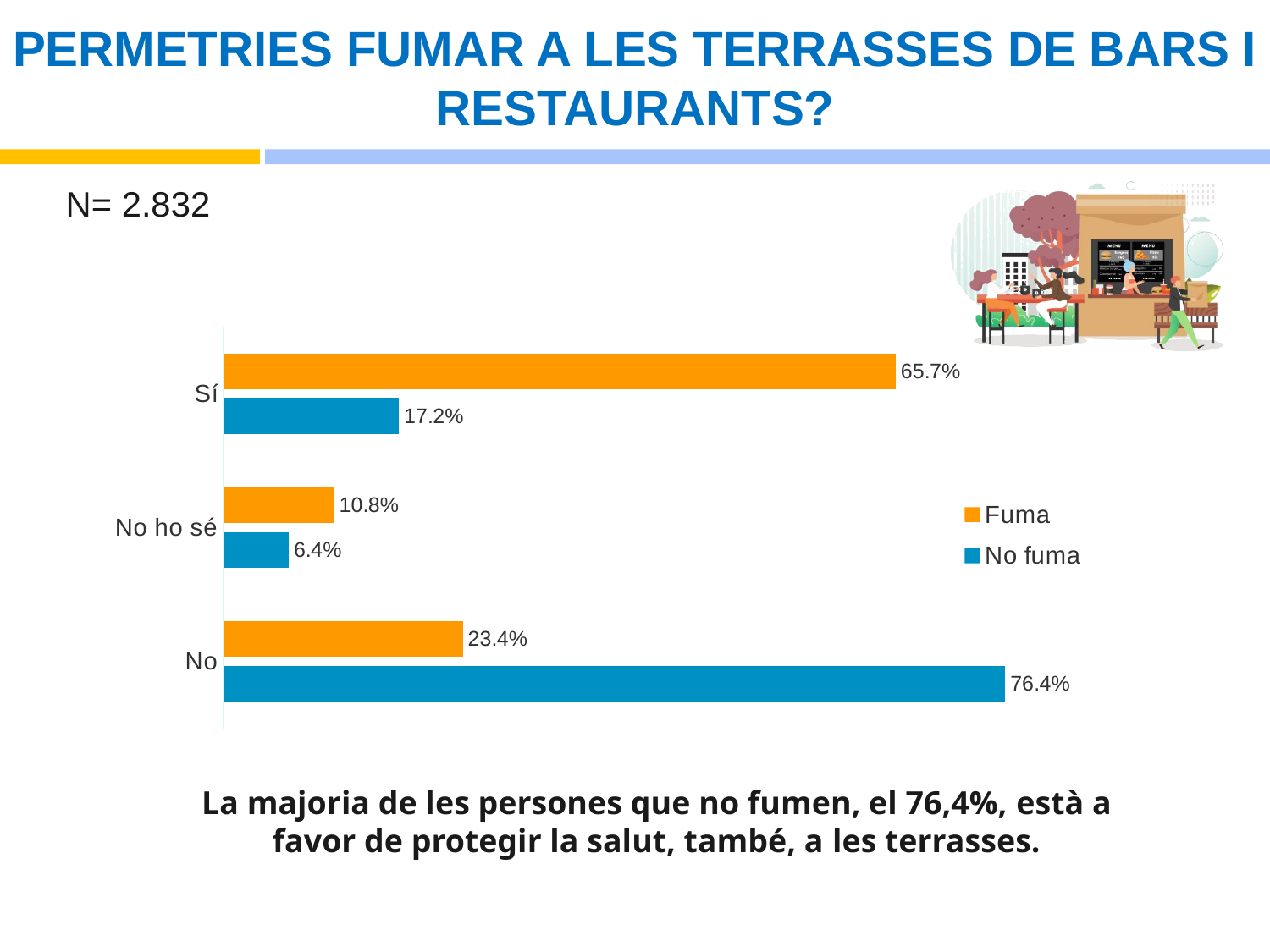
How many categories are shown on the chart? 3 Which category has the lowest value in the "Fuma" series? No ho sé Which is larger for "No ho sé": the "Fuma" value or the "No fuma" value? Fuma Which colour represents the "No fuma" series? Blue What is the value for "No" in the "No fuma" series? 76.4% Which category has the highest value in the "No fuma" series? No How many series does the legend list? 2 What is the difference between the "No fuma" and "Fuma" values for "No"? 53.0% What is the value for "No ho sé" in the "Fuma" series? 10.8% What is the value for "Sí" in the "No fuma" series? 17.2% What kind of chart is shown on the slide? Bar chart What is the value for "Sí" in the "Fuma" series? 65.7%